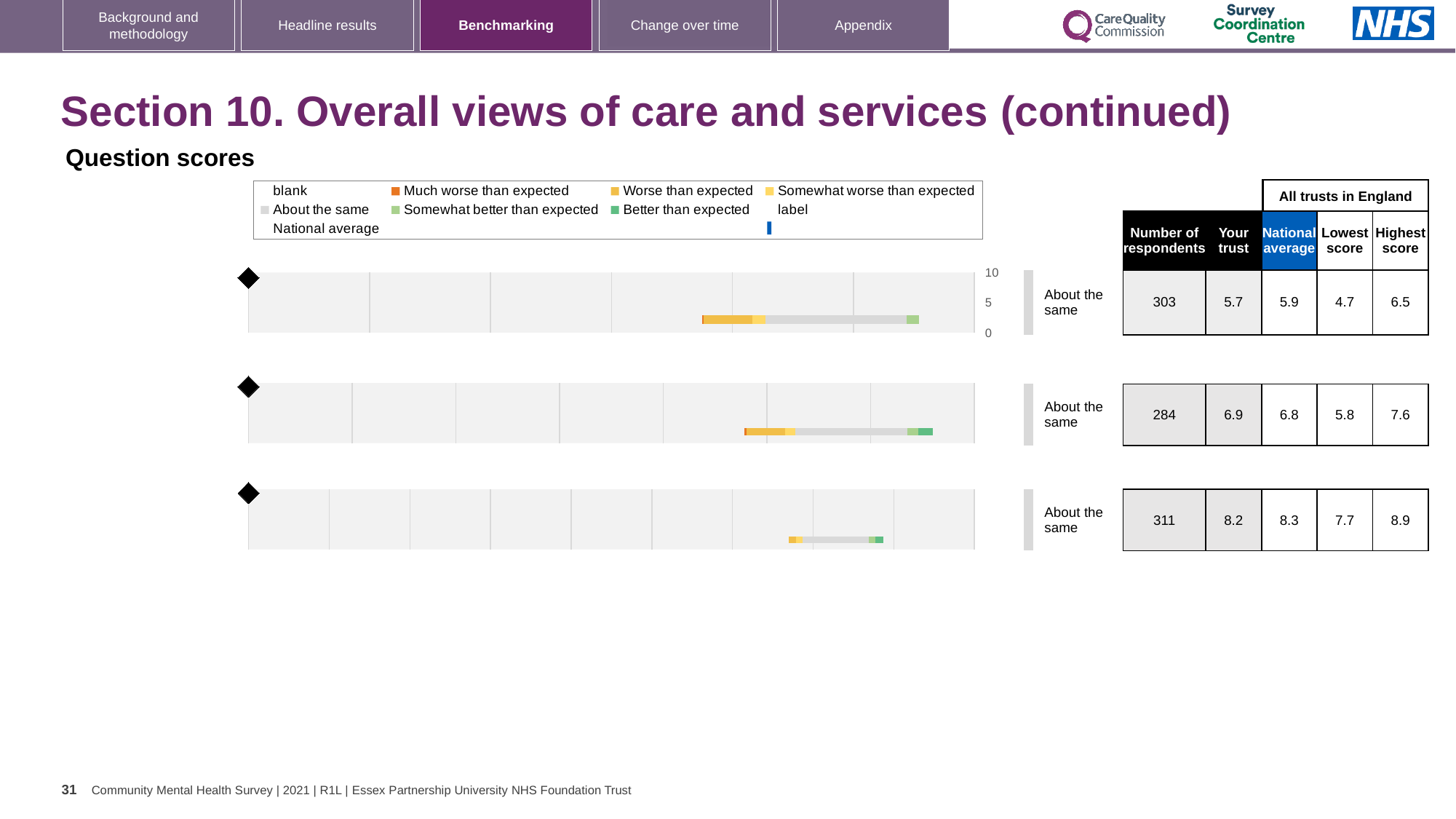
For the top chart, what is the difference between the highest score and the lowest score across all trusts in England? 1.8 What benchmark category is shown next to the top chart? About the same For the bottom chart, what is the difference between the national average and the 'Your trust' score? 0.1 Is the national average for the bottom chart greater or less than 5? greater For the bottom chart, how many respondents are there? 311 For the middle chart, what is the national average score? 6.8 For the middle chart, which is larger: the 'Your trust' score or the national average? Your trust For the top chart, what is the 'Your trust' score? 5.7 How many question score charts are shown on the slide? 3 Which chart (top, middle or bottom) has the lowest number of respondents? middle Which chart (top, middle or bottom) has the highest 'Your trust' score? bottom What type of chart is used to show the question scores on this slide? bar chart